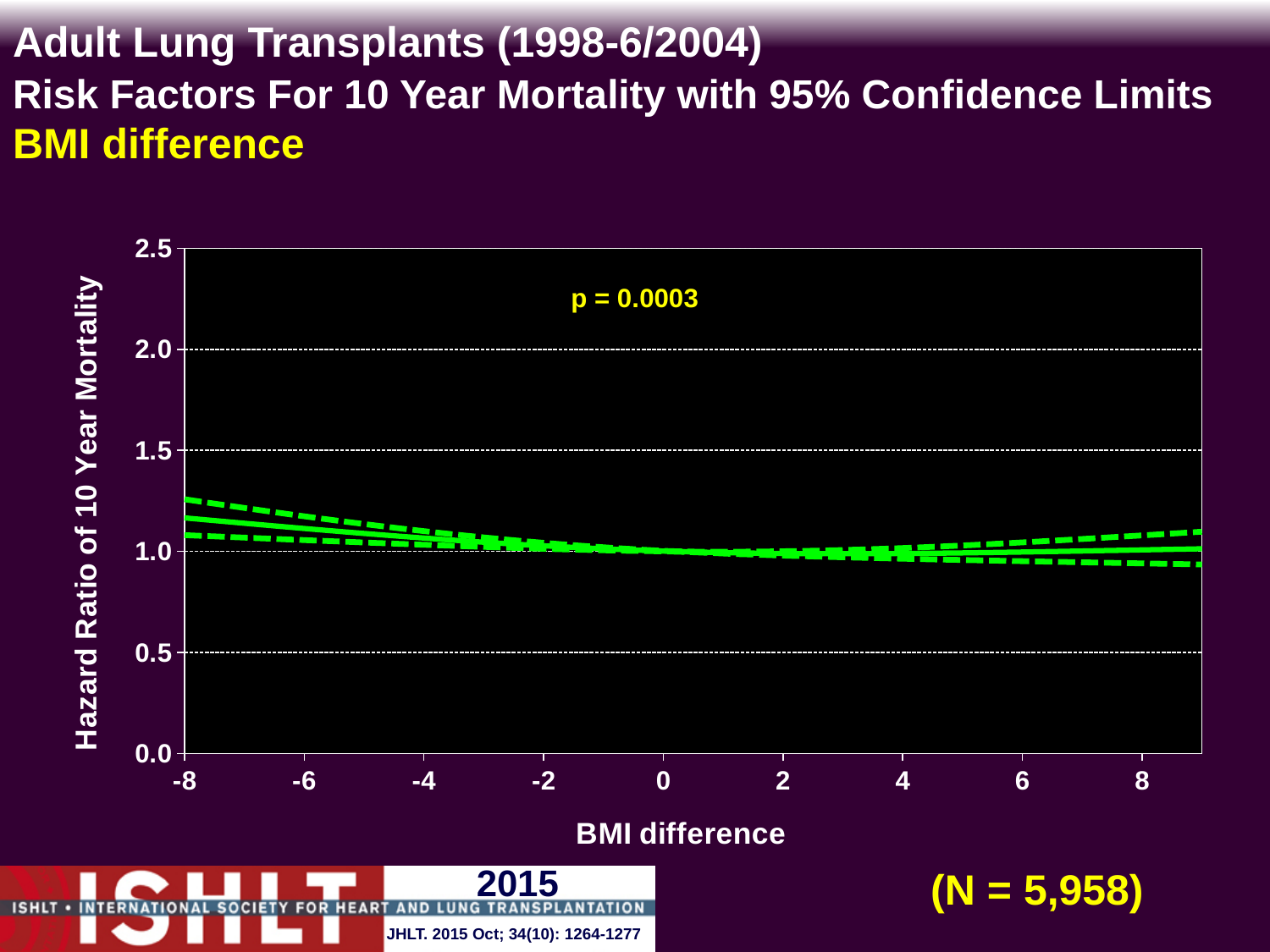
What kind of chart is shown on the slide? line chart What is the label of the y axis? Hazard Ratio of 10 Year Mortality What is the highest value shown on the y axis? 2.5 Does the hazard ratio (solid line) rise or fall as the BMI difference goes from -8 to 0? fall Is the upper confidence limit at a BMI difference of 8 greater or less than 1.5? less What p-value is printed on the chart? p = 0.0003 Is the hazard ratio (solid line) at a BMI difference of -8 greater or less than 1.5? less Is the hazard ratio (solid line) at a BMI difference of -8 greater or less than 1.0? greater How many labeled tick marks are on the x axis? 9 What is the label of the x axis? BMI difference What sample size (N) is printed on the slide? 5,958